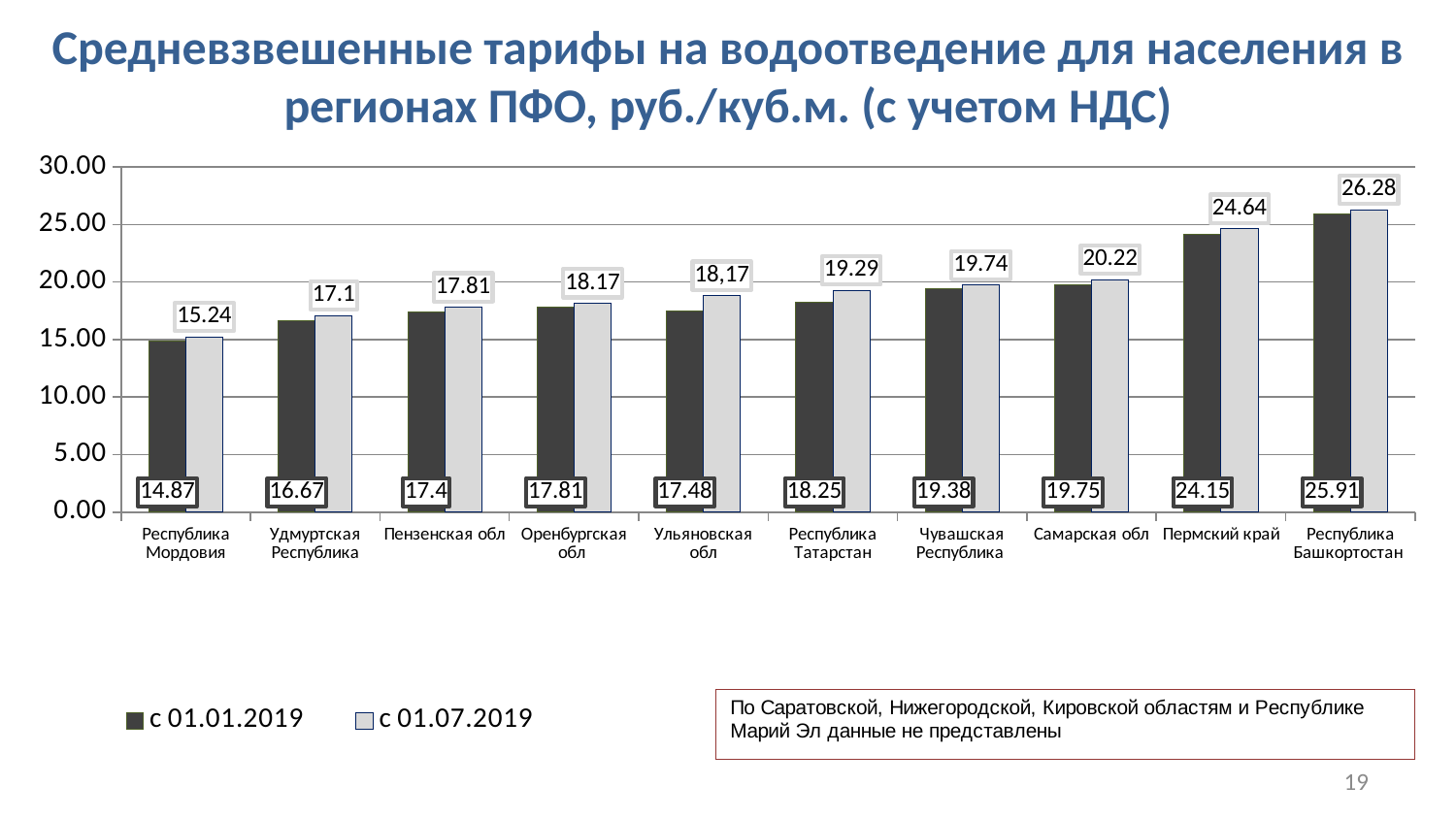
What is the value for Республика Татарстан in the series с 01.07.2019? 19.29 Which region has the lowest value in the series с 01.01.2019? Республика Мордовия Is the с 01.07.2019 value for Пермский край greater or less than 20.00? greater Which is larger: the с 01.01.2019 value for Чувашская Республика or the с 01.01.2019 value for Республика Татарстан? Чувашская Республика What is the difference between the с 01.07.2019 and с 01.01.2019 values for Самарская обл? 0.47 How many series does the legend list? 2 What is the value for Пермский край in the series с 01.01.2019? 24.15 Which region has the highest value in the series с 01.07.2019? Республика Башкортостан What is the value for Республика Мордовия in the series с 01.07.2019? 15.24 What kind of chart is shown on the slide? bar chart How many regions are shown on the x axis of the chart? 10 What are the two series named in the legend? с 01.01.2019 and с 01.07.2019